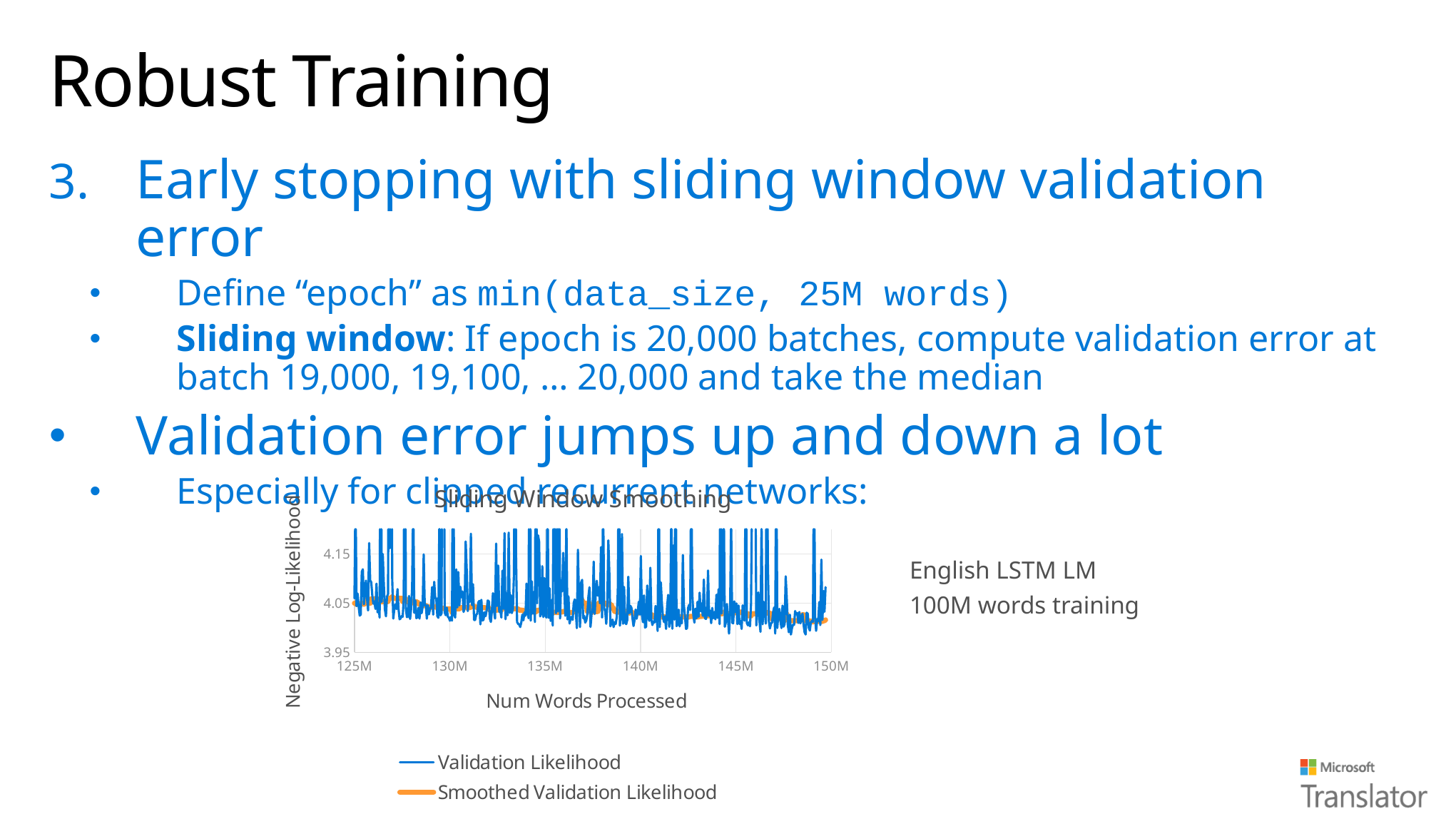
How many labelled tick marks are shown on the x axis of the chart? 6 Does the Smoothed Validation Likelihood line rise or fall overall from 125M to 150M words processed? fall Do the highest spikes of the Validation Likelihood series go greater or less than 4.15? greater Which series shows more fluctuation, Validation Likelihood or Smoothed Validation Likelihood? Validation Likelihood How many series does the chart's legend list? 2 What kind of chart is shown on the slide? line chart What is the lowest value labelled on the y axis of the chart? 3.95 Which series is drawn in orange in the chart? Smoothed Validation Likelihood What is the title of the chart? Sliding Window Smoothing Is the Smoothed Validation Likelihood value at 125M words processed greater or less than 4.15? less Is the Smoothed Validation Likelihood value at 150M words processed greater or less than 4.05? less